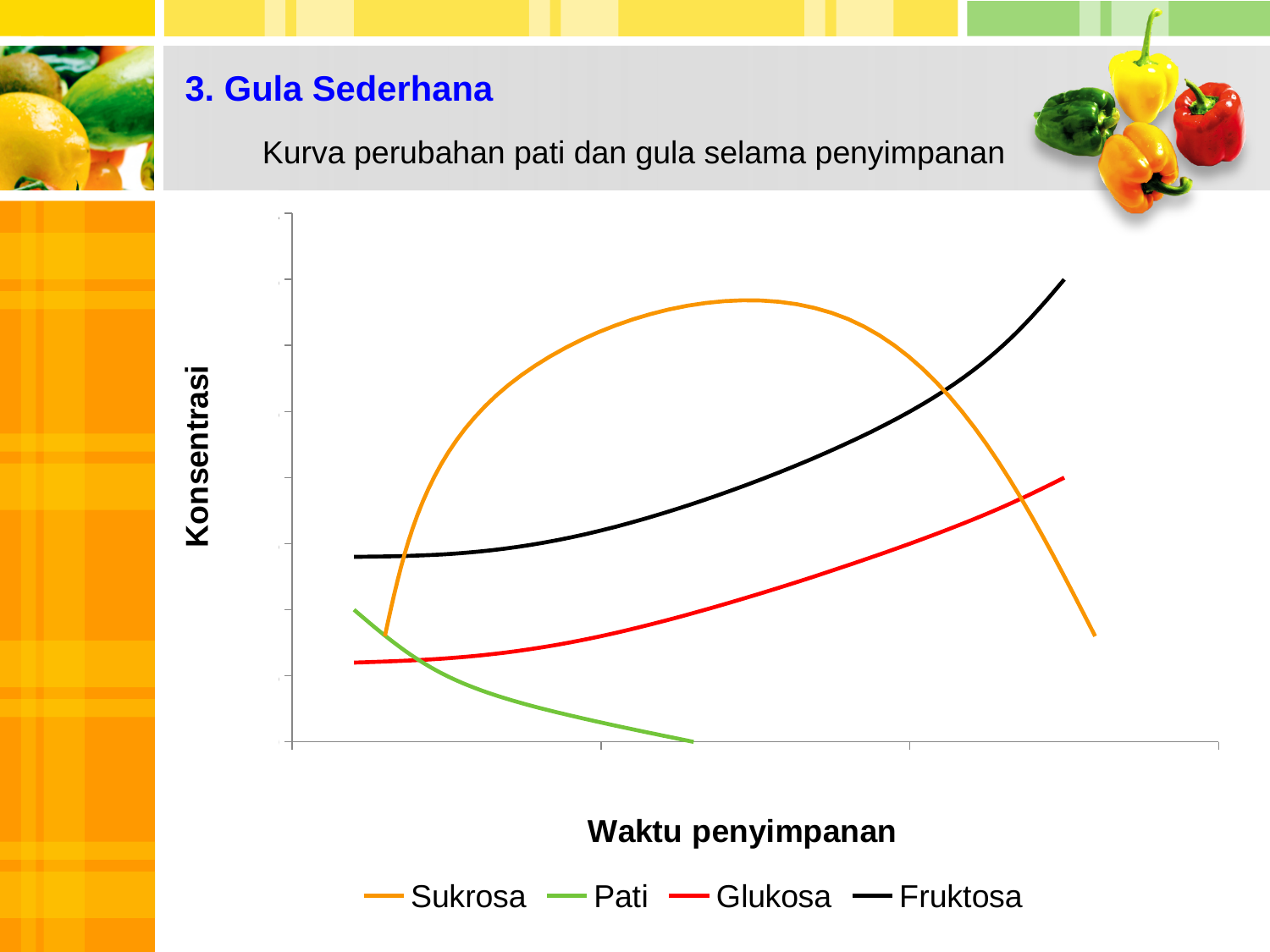
How does the Sukrosa curve change over storage time? rises then falls Which series are listed in the chart legend? Sukrosa, Pati, Glukosa, Fruktosa Does the Pati curve rise or fall along the storage time axis? fall How many series does the chart legend list? 4 What is the label of the vertical axis of the chart? Konsentrasi Which series has the highest concentration at the end of the storage time shown? Fruktosa Does the Glukosa curve rise or fall along the storage time axis? rise Which series has the lowest concentration at the end of the storage time shown? Pati At the start of storage, which is higher: Fruktosa or Glukosa? Fruktosa Which series reaches the highest peak concentration on the chart? Fruktosa What kind of chart is shown on the slide? line chart